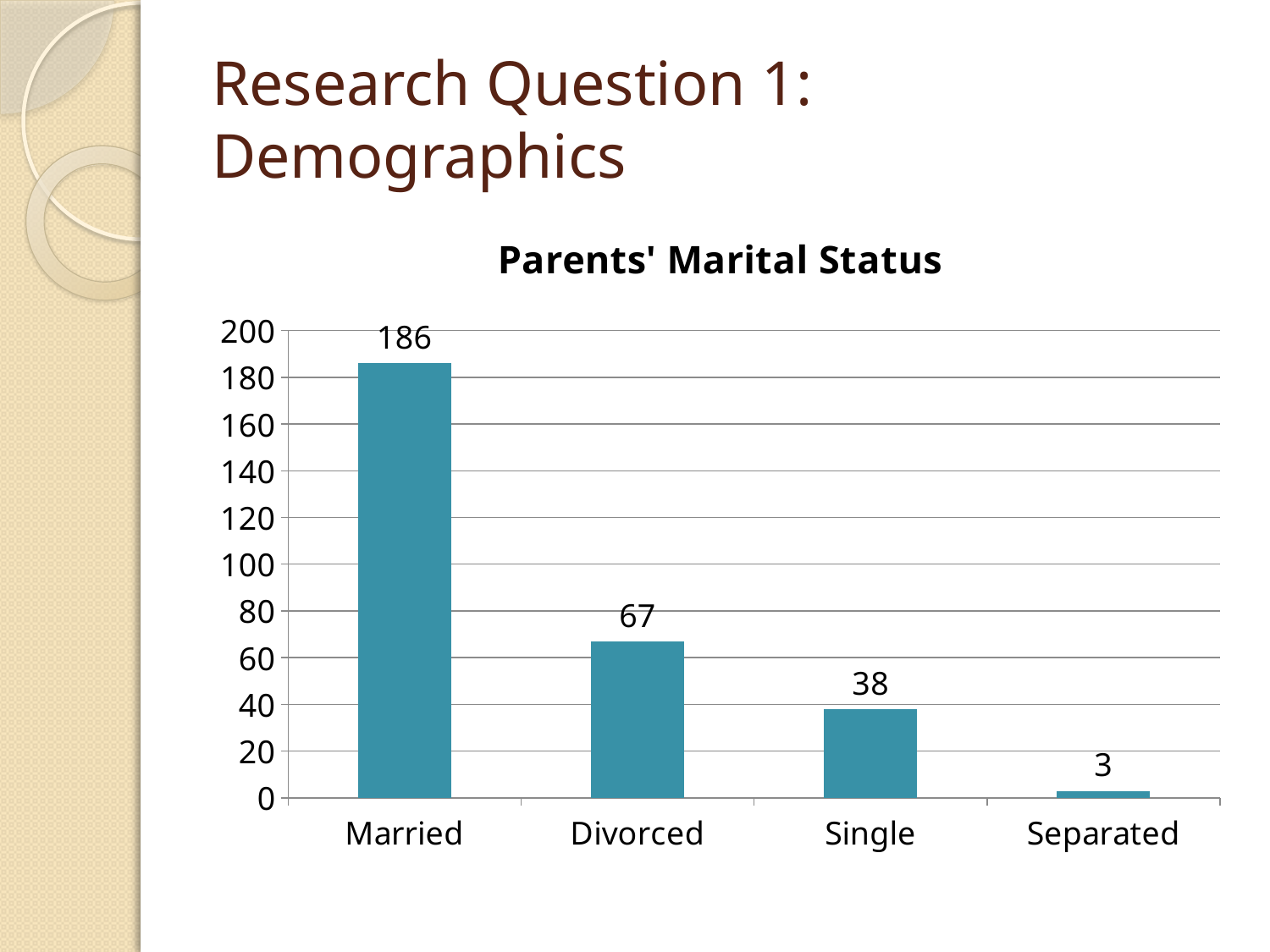
What kind of chart is shown on the slide? Bar chart What is the value for Married? 186 What is the value for Separated? 3 Which is larger, the value for Single or the value for Separated? Single How many categories are shown on the x axis? 4 What is the value for Single? 38 What is the difference between the values for Divorced and Single? 29 What is the difference between the values for Married and Divorced? 119 What is the title of the chart? Parents' Marital Status What is the value for Divorced? 67 Which category has the highest value? Married Which category has the lowest value? Separated